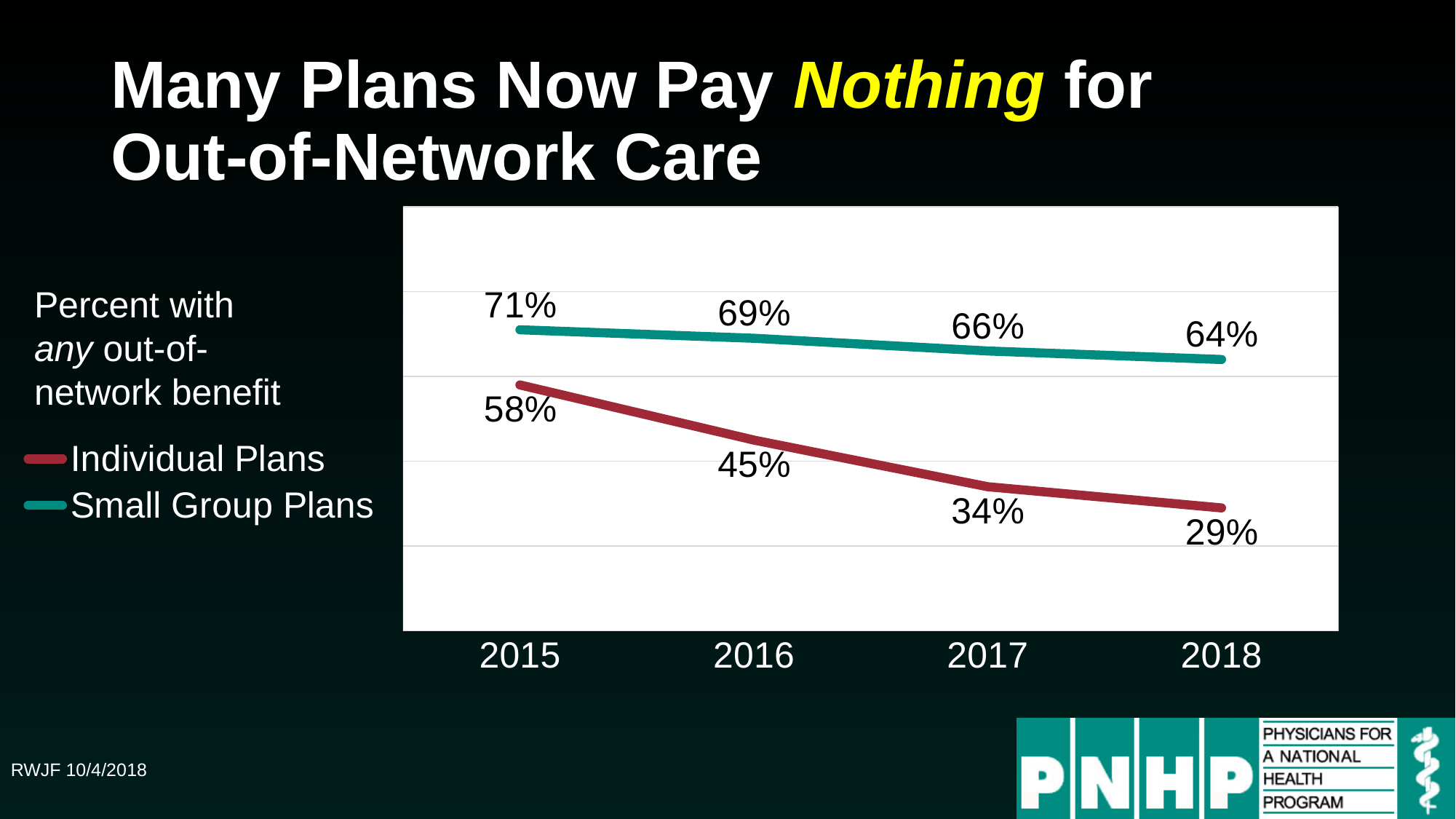
What is the difference between Small Group Plans and Individual Plans in 2018? 35 percentage points How many years are shown on the x axis? 4 In which year is the Individual Plans value lowest? 2018 In which year is the Small Group Plans value highest? 2015 What percent of Small Group Plans had any out-of-network benefit in 2018? 64% What kind of chart is shown on the slide? Line chart By how many percentage points did the Individual Plans value fall from 2015 to 2018? 29 percentage points How many series does the legend list? 2 What is the value for Individual Plans in 2017? 34% Which series has the higher value in 2016, Individual Plans or Small Group Plans? Small Group Plans What percent of Individual Plans had any out-of-network benefit in 2015? 58% What is the value for Small Group Plans in 2016? 69%